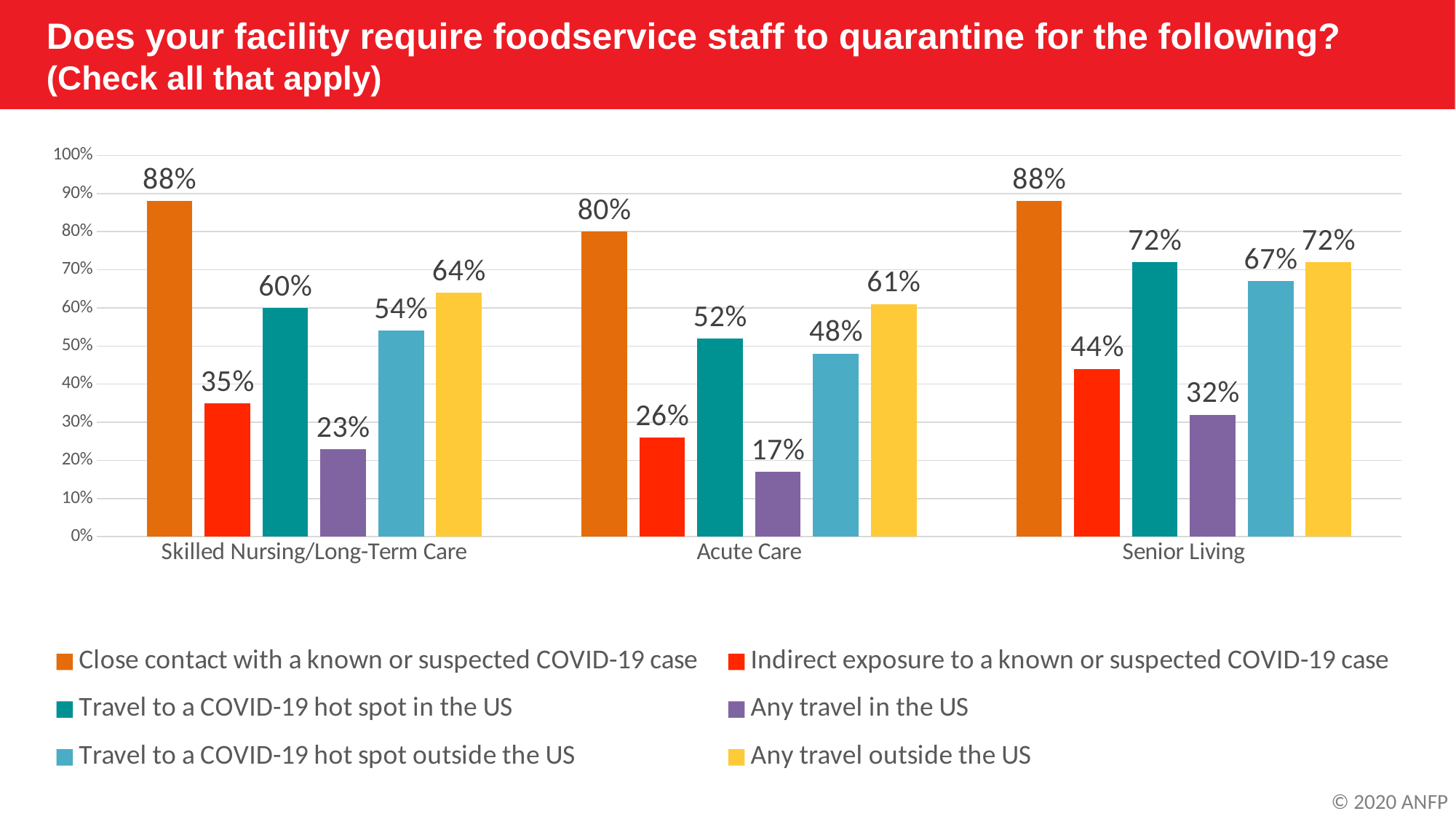
Which series has the highest value in the Acute Care category? Close contact with a known or suspected COVID-19 case What kind of chart is shown on the slide? Bar chart Which colour represents 'Any travel outside the US' in the legend? Yellow What is the value for 'Any travel in the US' in the Senior Living category? 32% What percentage of Acute Care facilities require quarantine for close contact with a known or suspected COVID-19 case? 80% Which is larger: 'Indirect exposure to a known or suspected COVID-19 case' for Skilled Nursing/Long-Term Care or for Senior Living? Senior Living What is the difference between the 'Travel to a COVID-19 hot spot in the US' values for Senior Living and Acute Care? 20% Which category has the lowest value for 'Any travel in the US'? Acute Care How many series does the legend list? 6 Is the value for 'Any travel outside the US' in Acute Care greater or less than 50%? greater How many facility categories are shown on the x axis? 3 What is the value for 'Travel to a COVID-19 hot spot outside the US' for Skilled Nursing/Long-Term Care? 54%